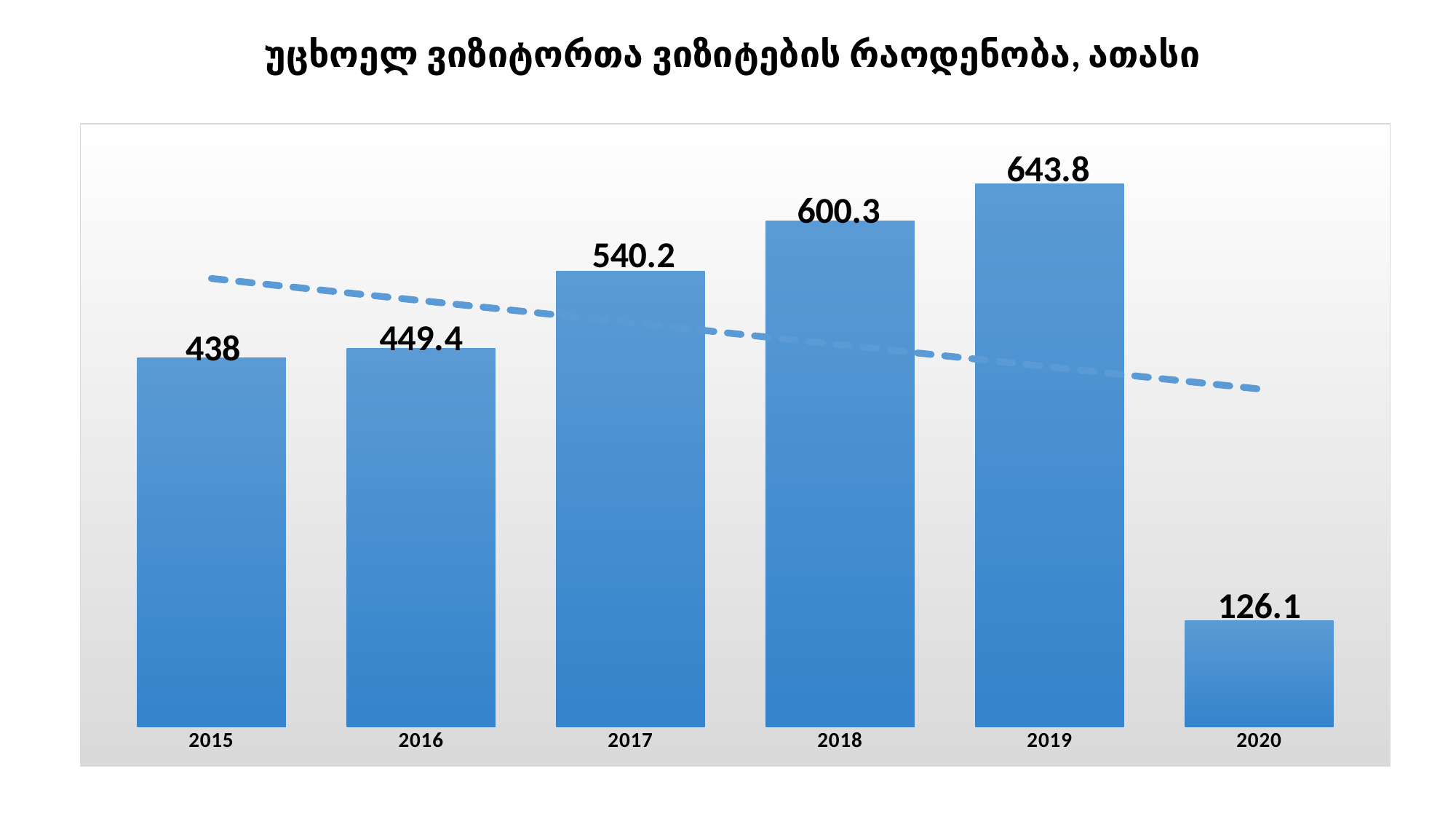
What is the value for 2017? 540.2 What is the value for 2020? 126.1 What kind of chart is this? bar chart Which is larger, the value for 2017 or the value for 2016? 2017 What is the difference between the values for 2019 and 2018? 43.5 Which year has the highest value? 2019 How many years are shown on the x axis? 6 What is the value for 2015? 438 What does the dashed line on the chart represent? a trendline What is the difference between the values for 2016 and 2015? 11.4 Which year has the lowest value? 2020 Do the values rise or fall from 2015 to 2019? rise